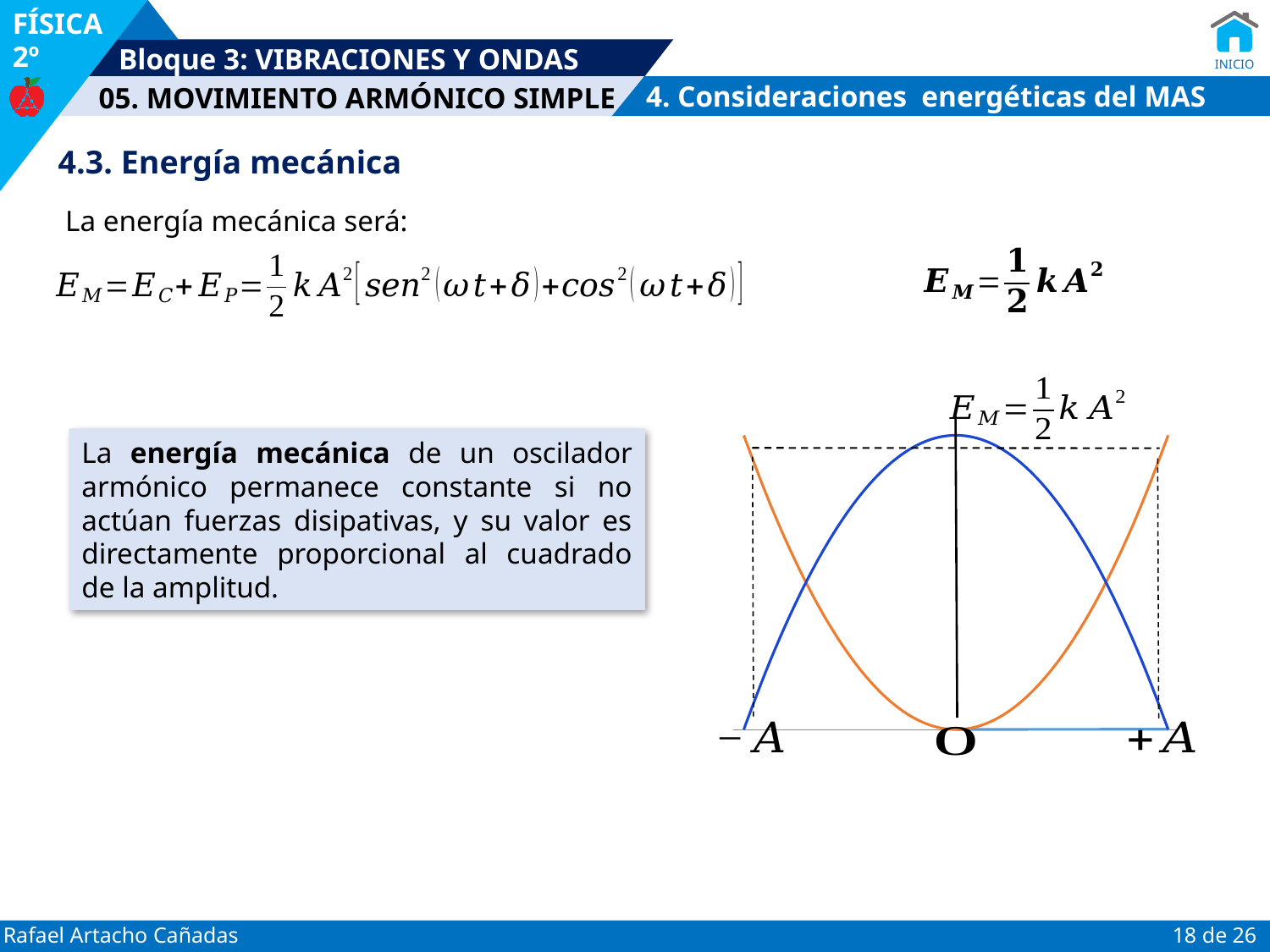
How many curves are plotted in the chart on the right? 2 Does the blue curve rise or fall as the position goes from −A to O? rise Does the orange curve rise or fall as the position goes from O to +A? rise At which horizontal-axis position does the blue curve reach its maximum? O At position O, which curve is higher, the blue one or the orange one? blue Does the blue curve rise or fall as the position goes from O to +A? fall At position −A, which curve is higher, the blue one or the orange one? orange At which horizontal-axis position does the orange curve reach its minimum? O What label is written above the dashed horizontal line at the top of the chart? E_M = 1/2 k A² How many labelled positions are marked along the horizontal axis of the chart? 3 What are the labels on the horizontal axis of the chart, from left to right? −A, O, +A What kind of chart is shown on the right of the slide? line chart